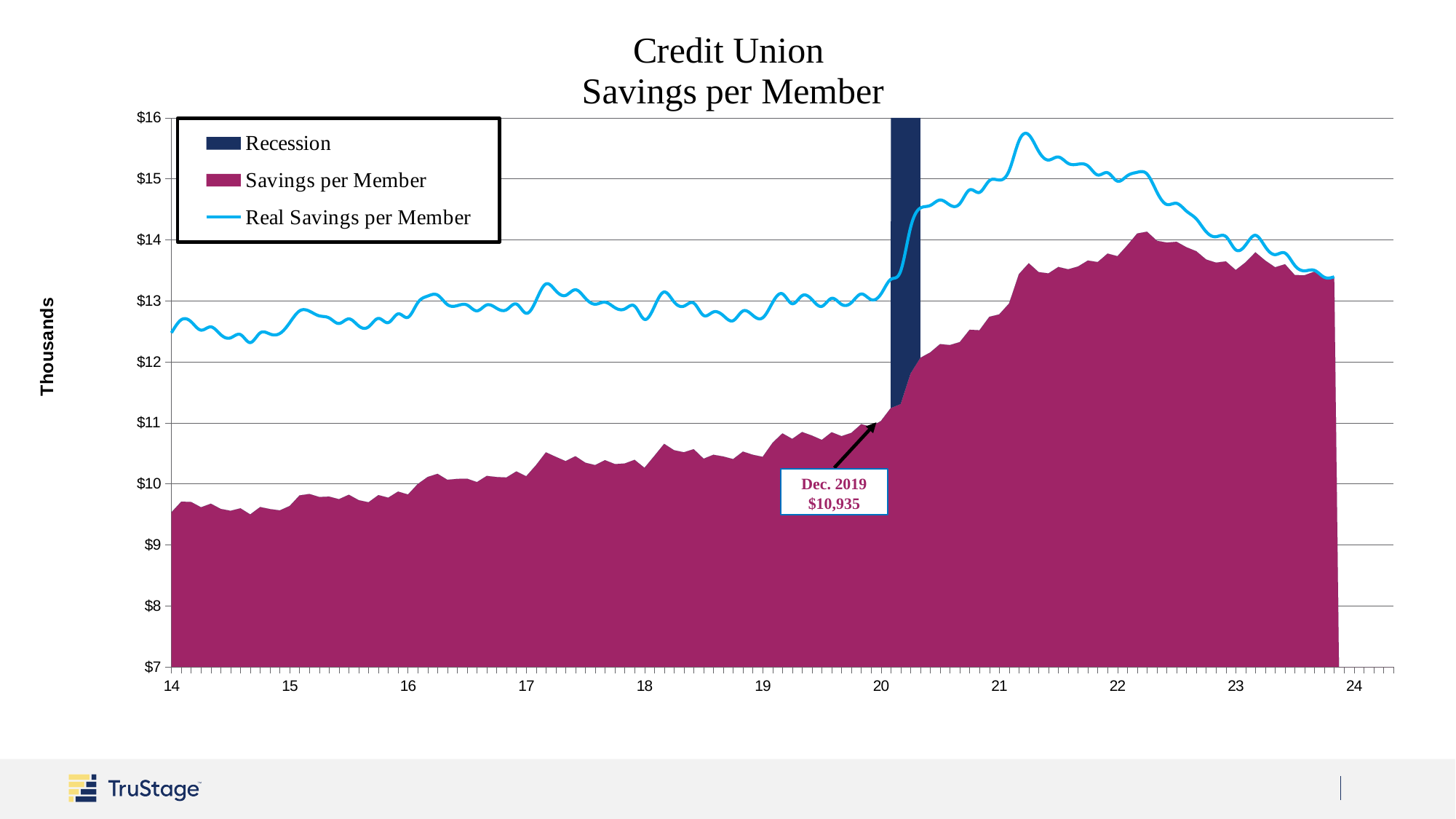
At the start of 14, which is higher: Real Savings per Member or Savings per Member? Real Savings per Member What kind of chart is shown on the slide? combination area and line chart Does Savings per Member generally rise or fall from 14 to 22? rise Is the peak of the Real Savings per Member line, around 21, greater or less than $15? greater How many entries does the legend list? 3 Is the Real Savings per Member value at the start of 14 greater or less than $12? greater Does the Real Savings per Member line rise or fall from its peak around 21 to the end of the chart? fall What is the title of the chart? Credit Union Savings per Member Is the Savings per Member value at 22 greater or less than $13? greater What is the label on the vertical axis? Thousands What value is labeled on the chart for Dec. 2019? $10,935